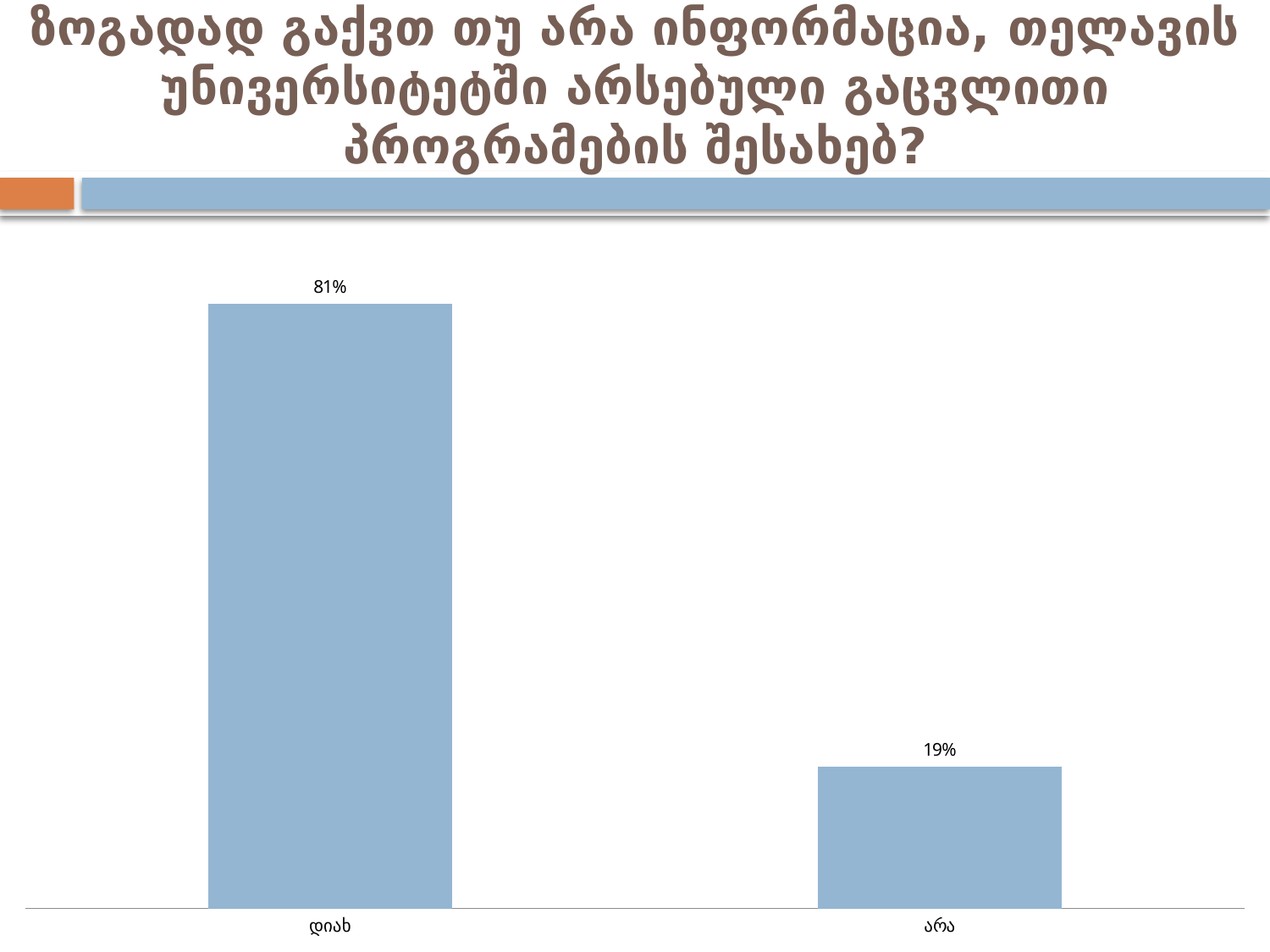
What is the total of the two values shown in the chart? 100% Which category has the highest value? დიახ What is the value for the category "არა"? 19% Which category has the lowest value? არა What kind of chart is shown on the slide? Bar chart What colour are the bars in the chart? Light blue What is the difference between the values for "დიახ" and "არა"? 62% What is the label of the left-hand bar? დიახ How many categories are shown in the chart? 2 Do the values rise or fall from left to right along the x axis? Fall What is the value for the category "დიახ"? 81% Which is larger, the value for "დიახ" or the value for "არა"? დიახ